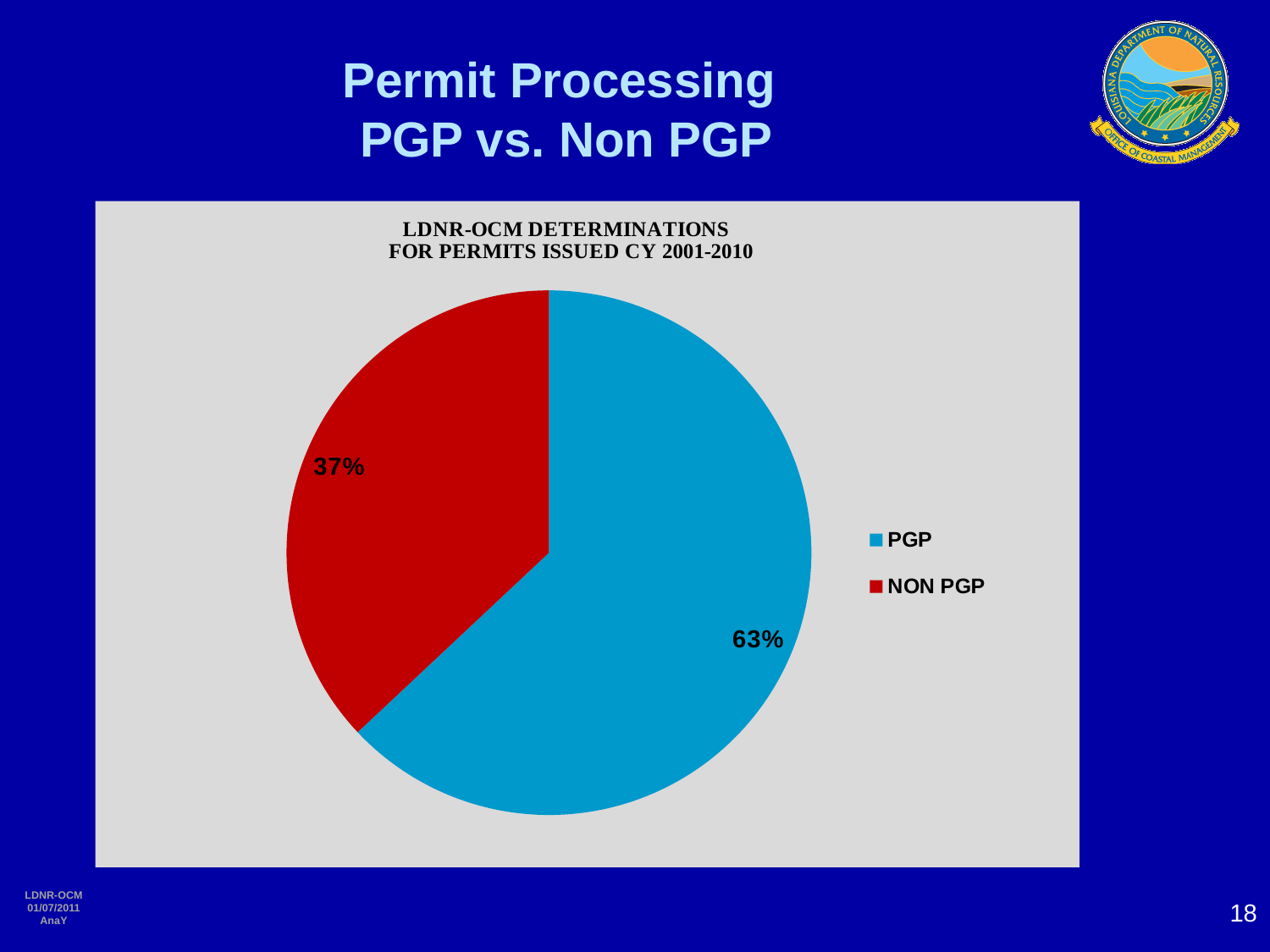
Which colour represents NON PGP in the legend? red What is the title of the chart? LDNR-OCM DETERMINATIONS FOR PERMITS ISSUED CY 2001-2010 Which category has the smallest slice of the pie? NON PGP What type of chart is shown on the slide? pie chart How many categories does the pie chart show? 2 What is the difference in percentage points between the PGP and NON PGP slices? 26 percentage points What share of the pie is NON PGP? 37% What share of the pie is PGP? 63% Which is larger, the PGP slice or the NON PGP slice? PGP Is the share for PGP greater or less than 50%? greater Which category has the largest slice of the pie? PGP